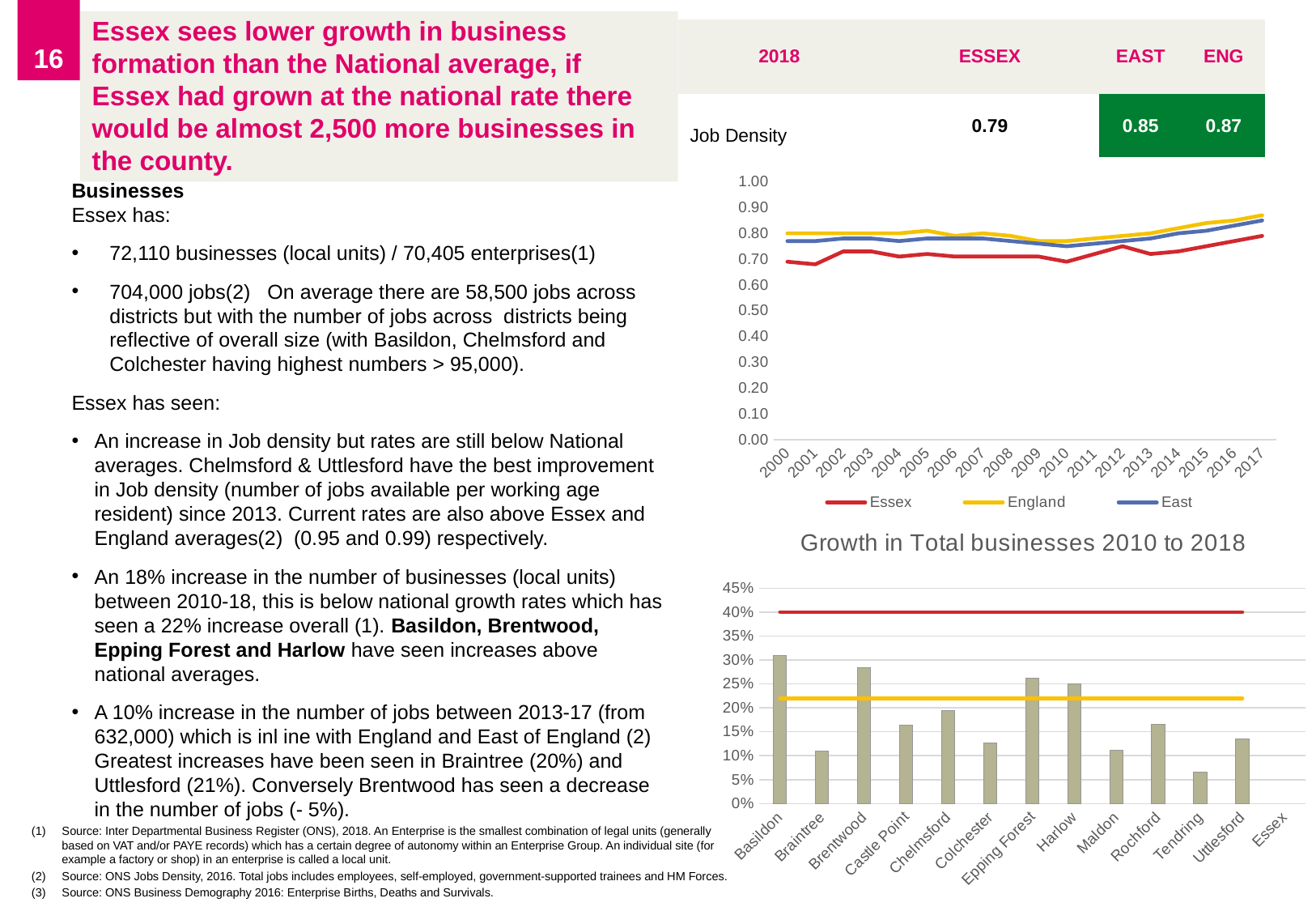
How many categories are shown on the x axis of the 'Growth in Total businesses 2010 to 2018' chart? 13 In the job density line chart, which series is drawn in red? Essex In the 'Growth in Total businesses 2010 to 2018' chart, which district has the lowest growth? Tendring In the 'Growth in Total businesses 2010 to 2018' chart, is the value for Braintree greater or less than 15%? less In the 'Growth in Total businesses 2010 to 2018' chart, which is larger, the value for Basildon or the value for Chelmsford? Basildon In the 'Growth in Total businesses 2010 to 2018' chart, is the value for Tendring greater or less than 10%? less What kind of chart is the 'Growth in Total businesses 2010 to 2018' chart? bar chart In the job density line chart, does the Essex line overall rise or fall from 2000 to 2017? rise In the 'Growth in Total businesses 2010 to 2018' chart, which district has the highest growth? Basildon In the job density line chart, is the value for England in 2017 greater or less than 0.80? greater How many series does the legend of the job density line chart list? 3